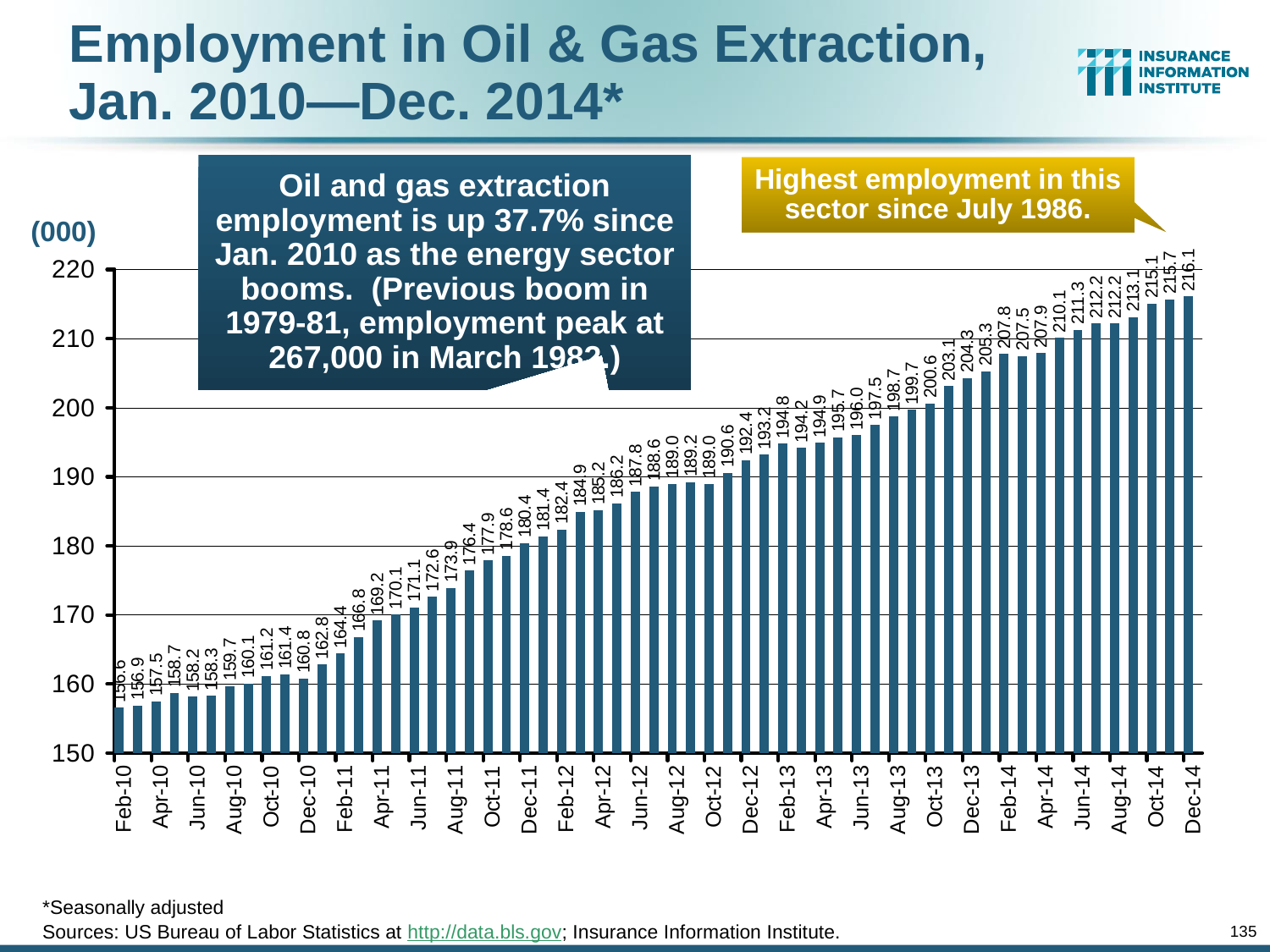
What is the employment value for Feb-10? 156.6 What is the employment value for Dec-14? 216.1 What kind of chart is shown on the slide? bar chart What is the difference between the values for Dec-13 and Dec-12? 11.9 Which month has the highest employment value in the chart? Dec-14 What is the difference between the values for Dec-14 and Dec-10? 55.3 Which is larger, the value for Dec-11 or the value for Dec-12? Dec-12 What unit label is shown above the y axis? (000) What is the employment value for Dec-12? 192.4 What is the employment value for Dec-10? 160.8 Do the values generally rise or fall from left to right along the x axis? rise Is the value for Dec-13 greater or less than 200? greater